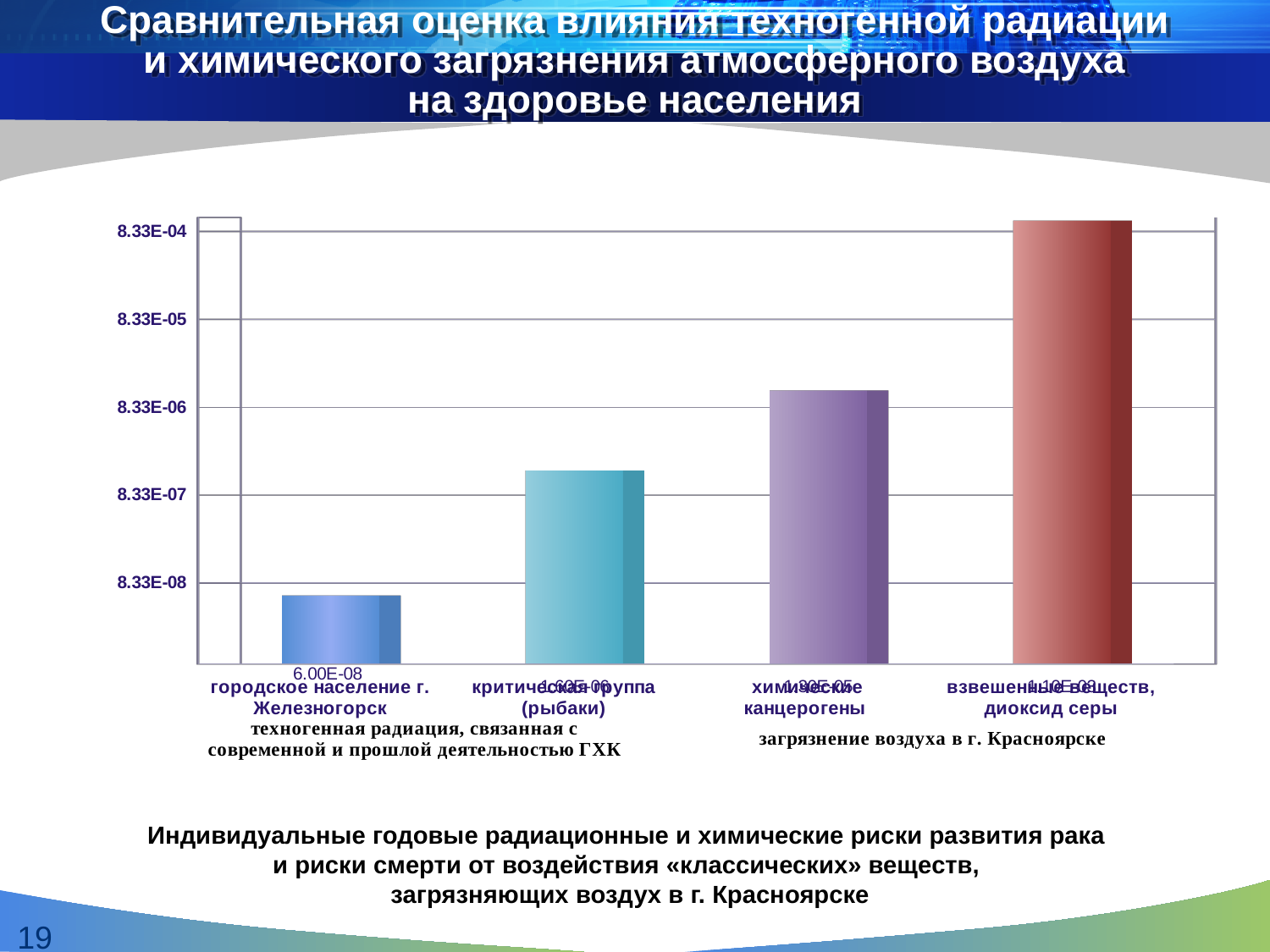
What type of chart is shown on the slide? bar chart Which bar is taller: 'химические канцерогены' or 'критическая группа (рыбаки)'? химические канцерогены What is the data label value for the bar 'городское население г. Железногорск'? 6.00E-08 Which category has the highest bar in the chart? взвешенные веществ, диоксид серы Is the value for 'городское население г. Железногорск' greater or less than 8.33E-08? less Do the bar values rise or fall from left to right across the categories? rise Is the value for 'критическая группа (рыбаки)' greater or less than 8.33E-07? greater What colour is the tallest bar in the chart? red Which category has the lowest bar in the chart? городское население г. Железногорск How many bars (categories) are plotted in the chart? 4 Is the value for 'химические канцерогены' greater or less than 8.33E-06? greater